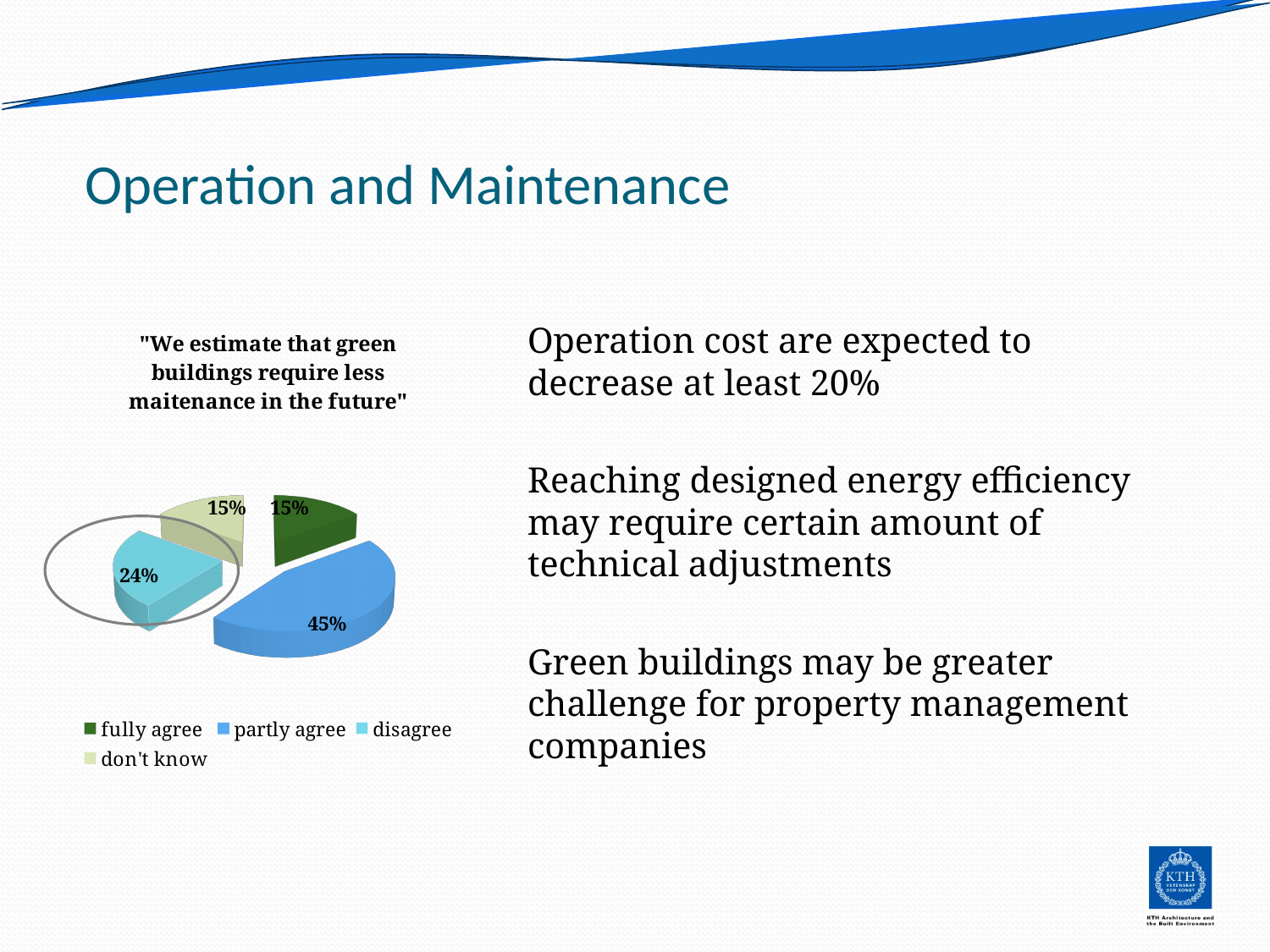
Which response category has the largest share of the pie chart? partly agree What percentage of respondents fully agree in the pie chart? 15% How many response categories are shown in the pie chart? 4 Which slice of the pie chart is circled? disagree What percentage of respondents partly agree that green buildings require less maintenance in the future? 45% What percentage of respondents answered "don't know" in the pie chart? 15% What percentage of respondents disagree in the pie chart? 24% What type of chart is shown on the slide? pie chart What is the difference in percentage points between the "partly agree" and "disagree" slices? 21 What is the combined share of respondents who fully agree or partly agree? 60% How many entries does the chart legend list? 4 Which slice is larger, "disagree" or "fully agree"? disagree